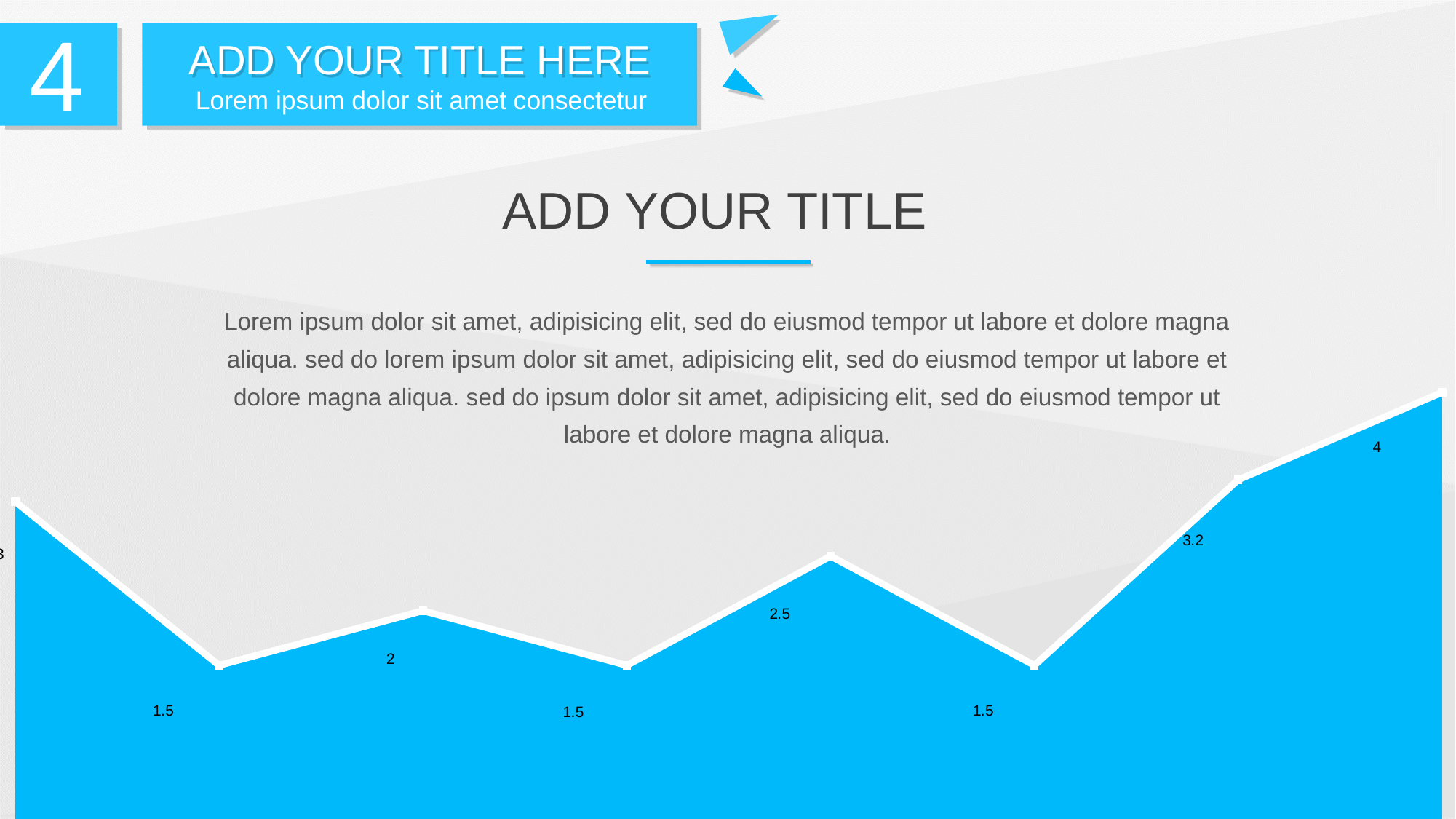
What is the value of the second-to-last data point on the chart? 3.2 Do the values rise or fall from the sixth data point to the last data point? Rise What is the difference between the fifth data point (2.5) and the sixth data point (1.5)? 1 What is the value of the fifth data point from the left on the chart? 2.5 What is the value of the rightmost (last) data point on the chart? 4 What colour is the filled area of the chart? Blue What is the lowest value labelled on the chart? 1.5 What is the highest value labelled on the chart? 4 What kind of chart is shown at the bottom of the slide? Area chart Which is larger: the value of the last data point or the value of the fifth data point? The last data point What is the difference between the last data point (4) and the second-to-last data point (3.2)? 0.8 What is the value of the third data point from the left on the chart? 2